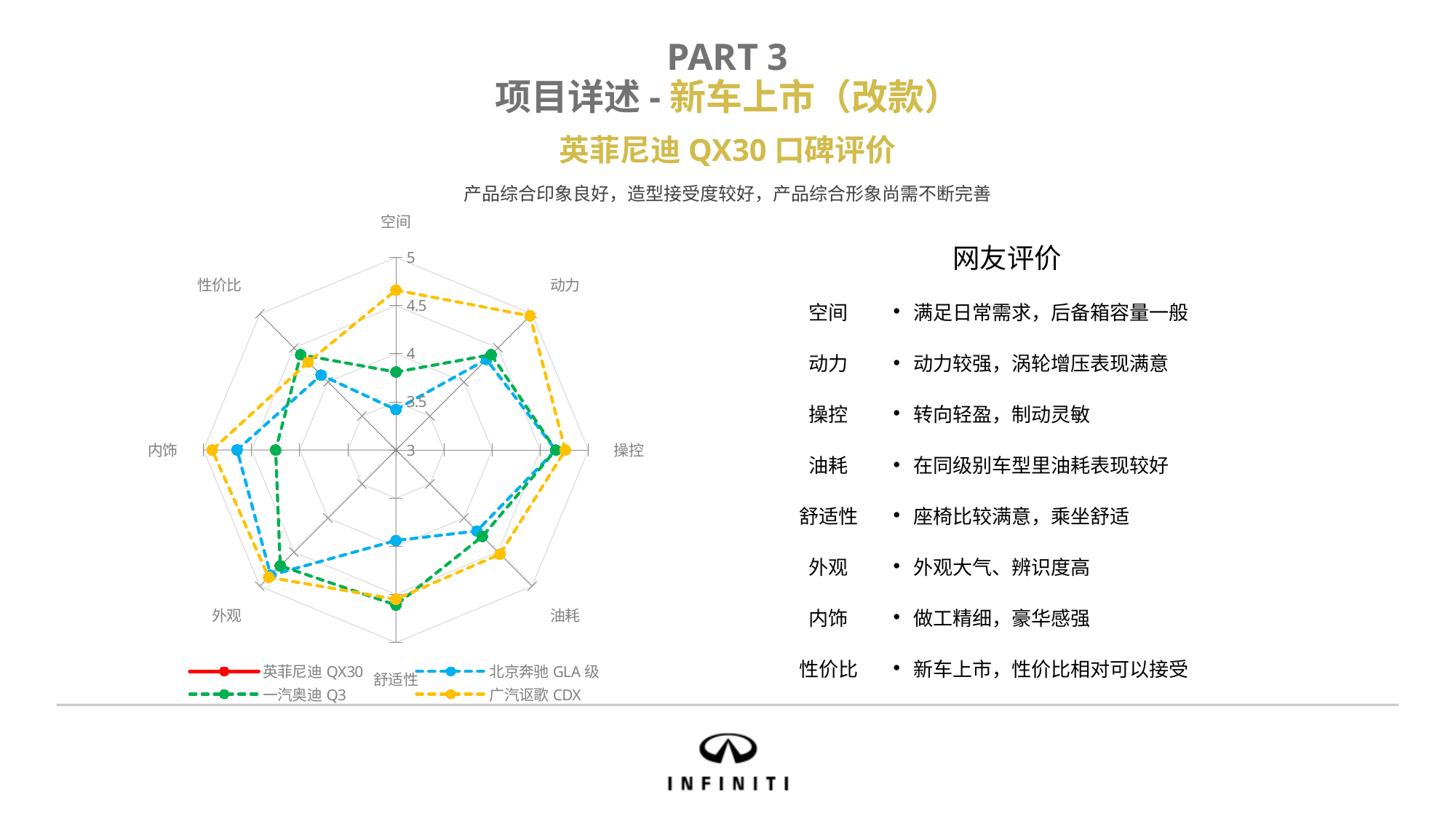
On which category does 广汽讴歌 CDX have its lowest value? 性价比 What kind of chart is shown on the slide? radar chart Which series has the highest value on 空间? 广汽讴歌 CDX Is the value for 北京奔驰 GLA 级 on 空间 greater or less than 4? less Is the value for 广汽讴歌 CDX on 内饰 greater or less than 4.5? greater Is the value for 北京奔驰 GLA 级 on 舒适性 greater or less than 4.5? less Which is larger on 空间: 广汽讴歌 CDX or 北京奔驰 GLA 级? 广汽讴歌 CDX How many categories (axes) does the radar chart have? 8 Which series is drawn in green in the chart legend? 一汽奥迪 Q3 How many series does the chart legend list? 4